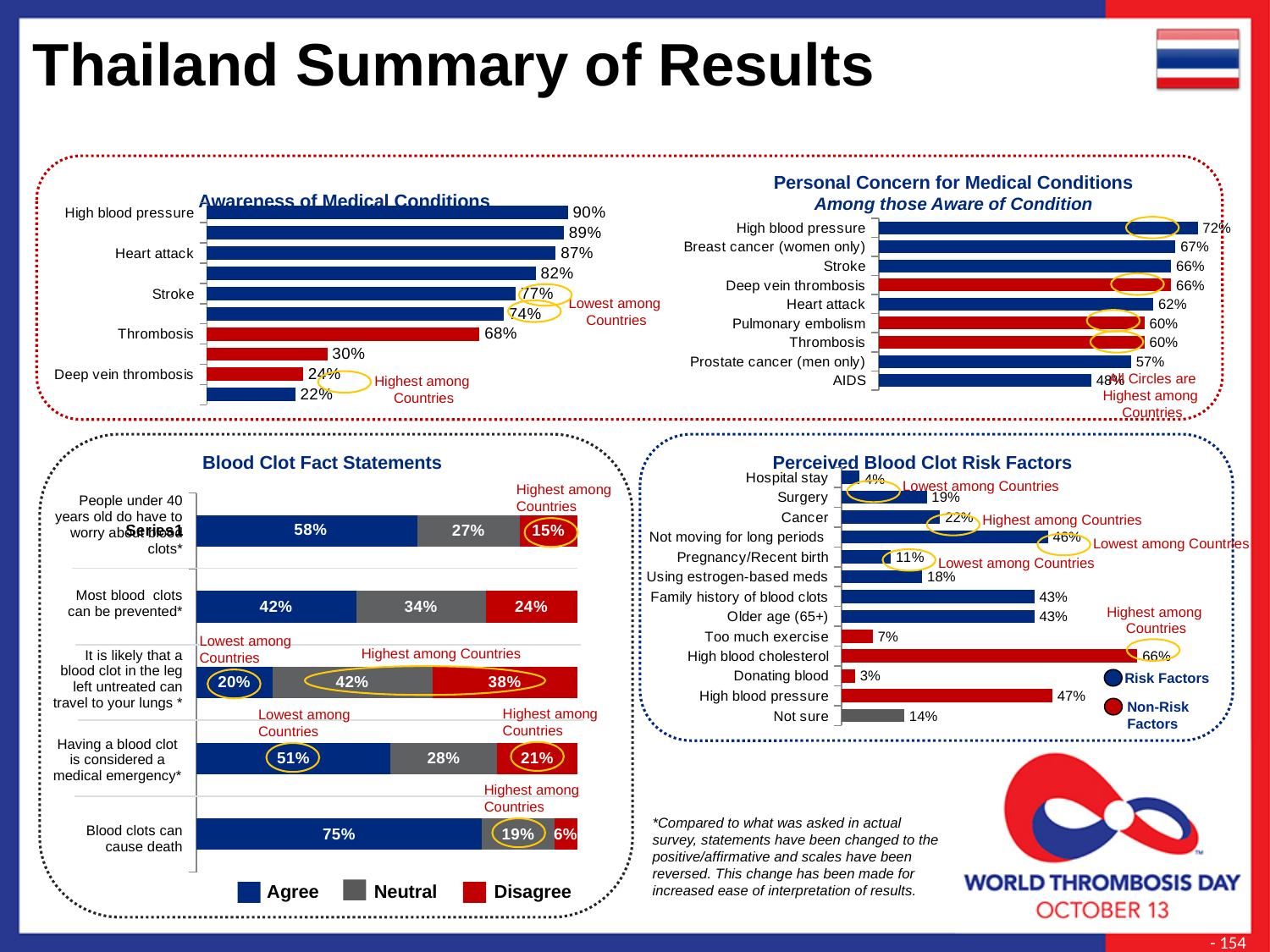
In the Perceived Blood Clot Risk Factors chart, which is larger: Surgery or Cancer? Cancer What type of chart is the Perceived Blood Clot Risk Factors chart? Bar chart In the Personal Concern for Medical Conditions chart, what is the difference between Heart attack and Prostate cancer (men only)? 5% In the Awareness of Medical Conditions chart, what is the highest value shown? 90% In the Perceived Blood Clot Risk Factors chart, what is the value for High blood cholesterol? 66% In the Blood Clot Fact Statements chart, how many series does the legend list? 3 In the Personal Concern for Medical Conditions chart, which condition has the lowest value? AIDS In the Personal Concern for Medical Conditions chart, how many conditions are listed? 9 In the Awareness of Medical Conditions chart, what is the value for High blood pressure? 90% In the Blood Clot Fact Statements chart, what is the Disagree value for 'Most blood clots can be prevented'? 24% In the Blood Clot Fact Statements chart, what percentage agree that blood clots can cause death? 75% In the Personal Concern for Medical Conditions chart, what is the value for High blood pressure? 72%